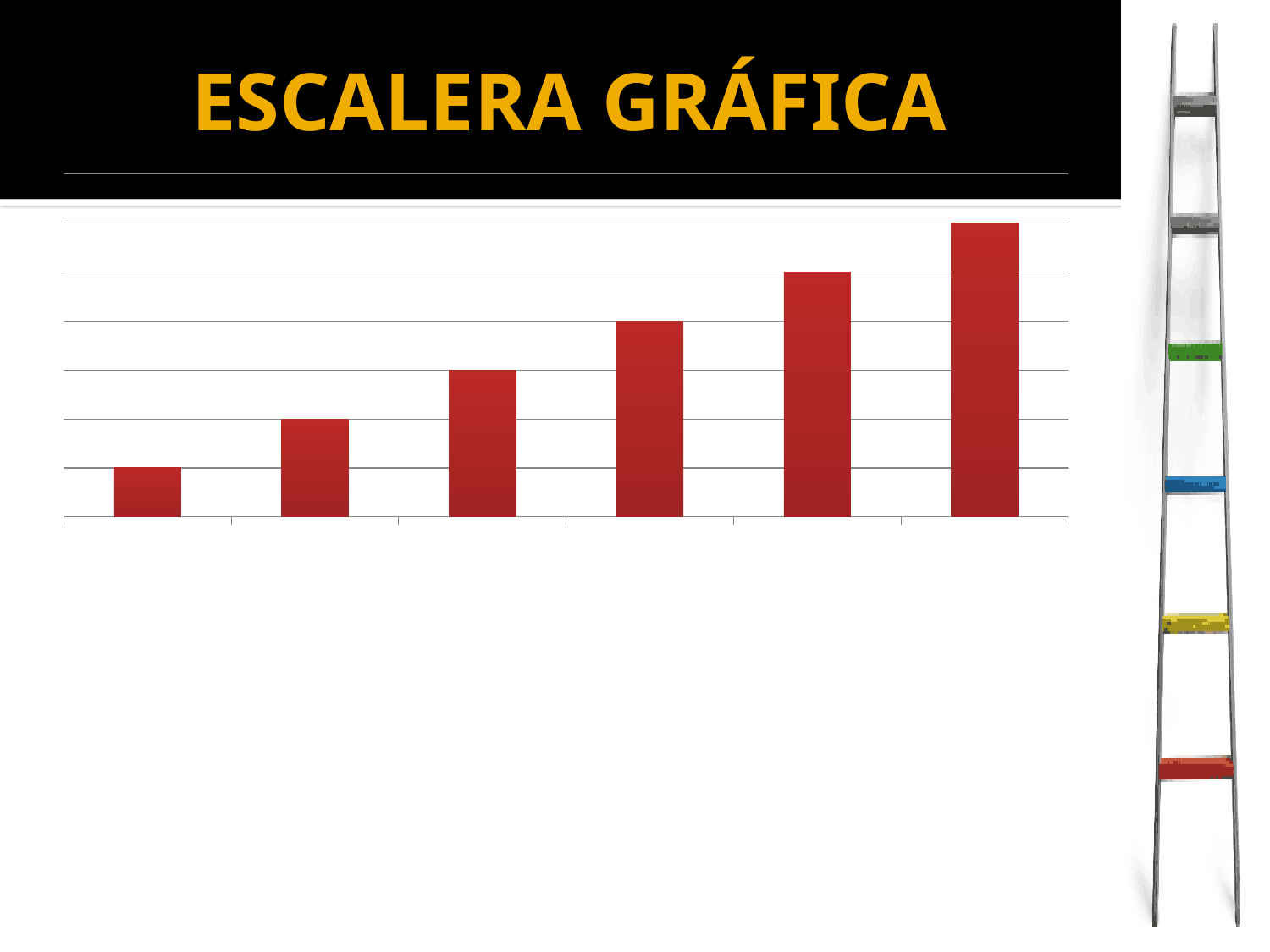
Which bar is the tallest in the chart? the rightmost bar Which is taller, the second bar from the left or the fifth bar from the left? the fifth bar from the left What is the title shown above the chart on the slide? ESCALERA GRÁFICA How many bars does the chart contain? 6 Which is taller, the third bar from the left or the fourth bar from the left? the fourth bar from the left What kind of chart is shown on the slide? bar chart Which bar is the shortest in the chart? the leftmost bar Do the bar values rise or fall from left to right across the chart? rise What colour are the bars in the chart? red